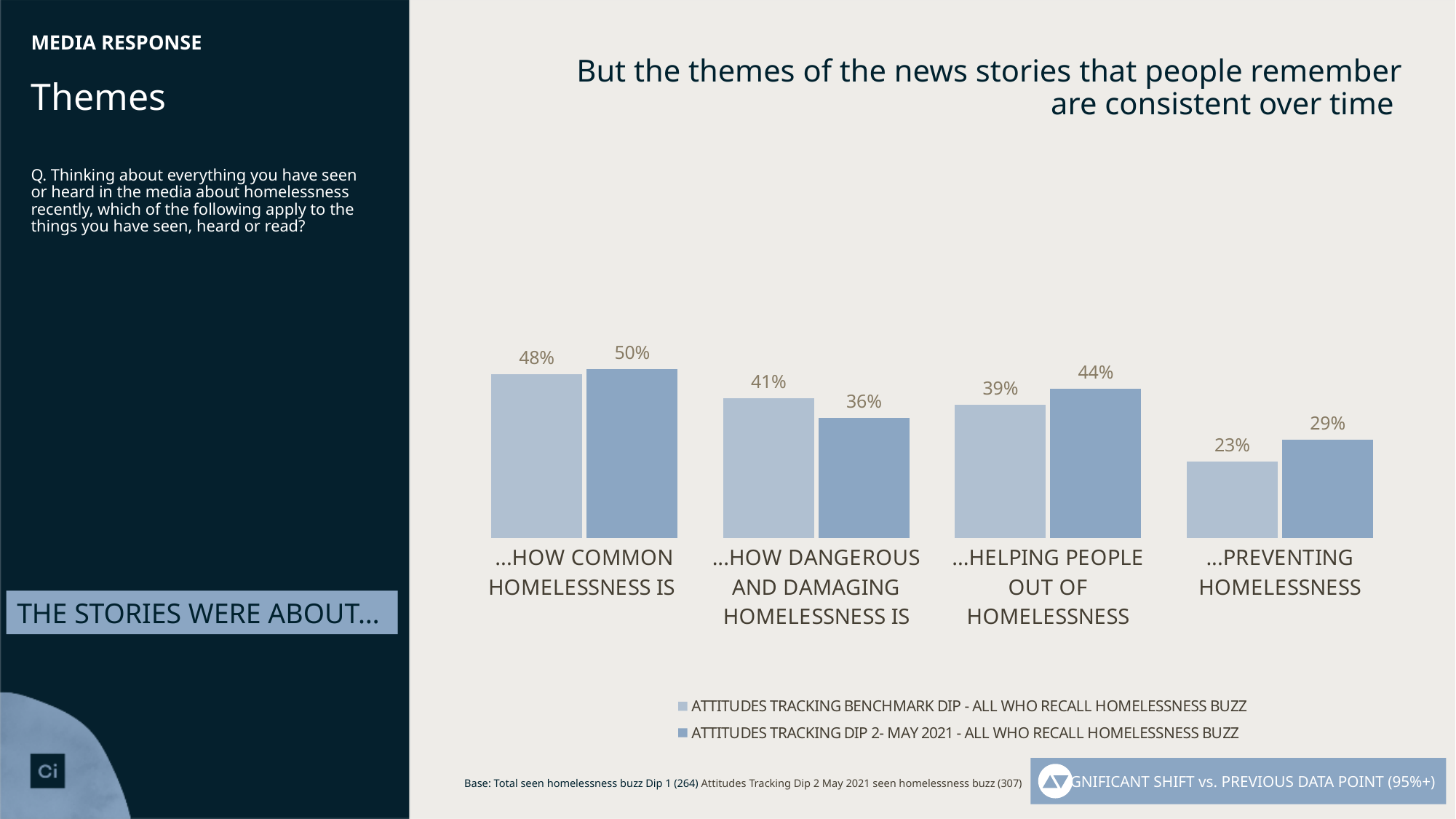
What is the value for '...how common homelessness is' in the Attitudes Tracking Dip 2 - May 2021 series? 50% What kind of chart is shown on the slide? Bar chart How many series does the legend list? 2 For '...how dangerous and damaging homelessness is', which series has the larger value: Benchmark Dip or Dip 2 - May 2021? Attitudes Tracking Benchmark Dip Which series is shown in the darker blue bars? Attitudes Tracking Dip 2 - May 2021 - All who recall homelessness buzz What is the difference between the Benchmark Dip and Dip 2 - May 2021 values for '...helping people out of homelessness'? 5% What is the value for '...preventing homelessness' in the Attitudes Tracking Benchmark Dip series? 23% Which theme has the highest value in the Attitudes Tracking Benchmark Dip series? ...how common homelessness is Which theme has the lowest value in the Attitudes Tracking Dip 2 - May 2021 series? ...preventing homelessness What is the difference between the Dip 2 - May 2021 value and the Benchmark Dip value for '...preventing homelessness'? 6% How many themes (categories) are shown on the chart? 4 What is the value for '...how dangerous and damaging homelessness is' in the Attitudes Tracking Dip 2 - May 2021 series? 36%